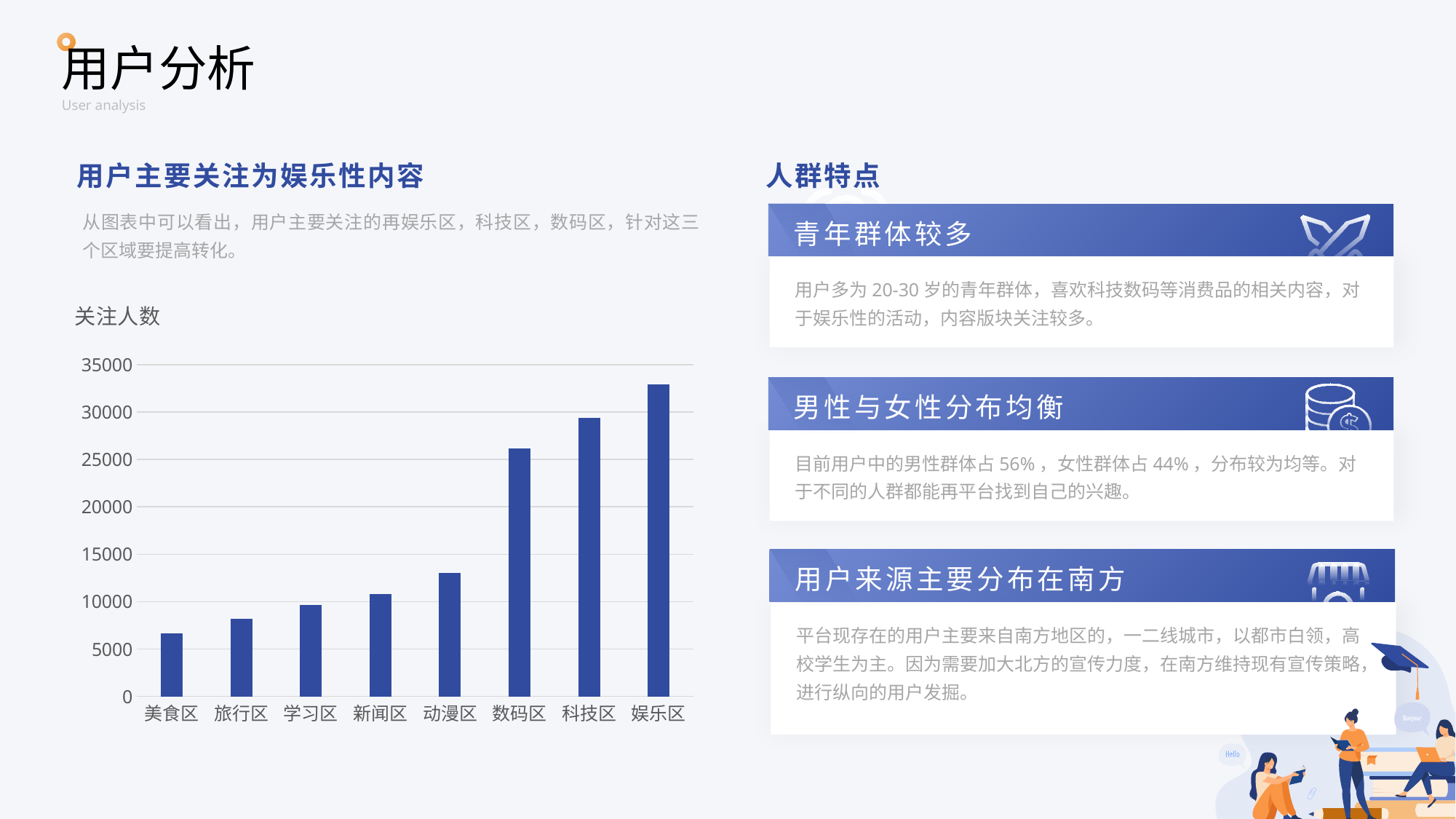
Is the value for 数码区 greater or less than 25000? greater Which category has the highest value in the 关注人数 chart? 娱乐区 Is the value for 娱乐区 greater or less than 30000? greater Which category has the lowest value in the 关注人数 chart? 美食区 Is the value for 科技区 greater or less than 30000? less Which is larger, the value for 科技区 or the value for 数码区? 科技区 What is the title shown above the bar chart? 关注人数 Do the values rise or fall from left to right along the x axis of the 关注人数 chart? rise What kind of chart is shown under the heading 关注人数? bar chart How many categories are shown on the x axis of the 关注人数 chart? 8